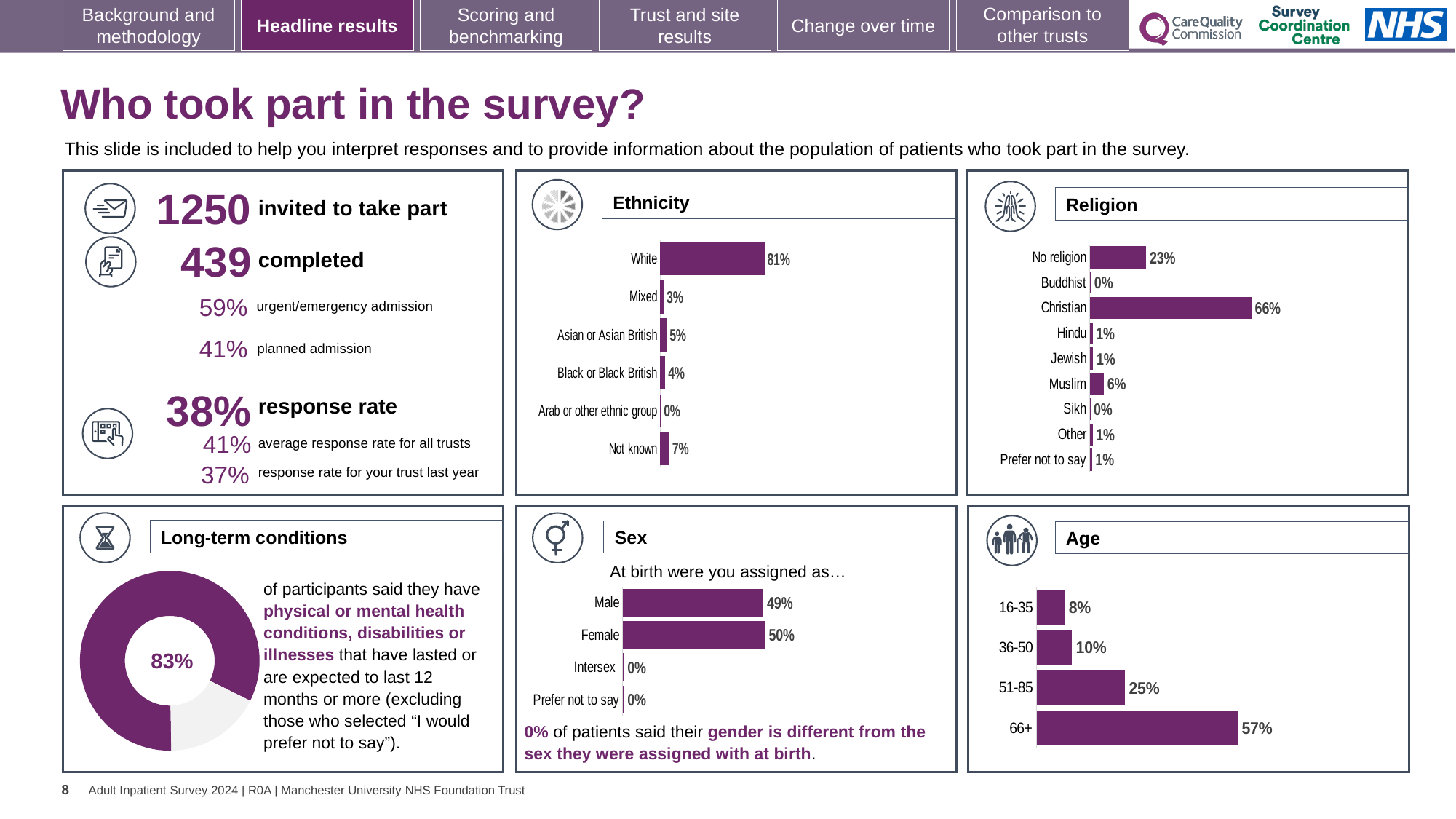
In the Long-term conditions chart, what share of participants said they have physical or mental health conditions, disabilities or illnesses? 83% In the Sex chart, is the value for Female larger or smaller than the value for Male? larger How many categories are shown in the Religion chart? 9 In the Age chart, do the values rise or fall as the age groups go from 16-35 to 66+? rise In the Age chart, which age group has the lowest value? 16-35 In the Ethnicity chart, what is the difference between the Not known and Mixed values? 4% What kind of chart is the Long-term conditions chart? Doughnut chart In the Ethnicity chart, what percentage of participants were White? 81% How many categories are shown in the Ethnicity chart? 6 In the Religion chart, which religion category has the highest value? Christian In the Age chart, what is the difference between the 66+ and 51-85 values? 32% In the Religion chart, what is the value for Muslim? 6%